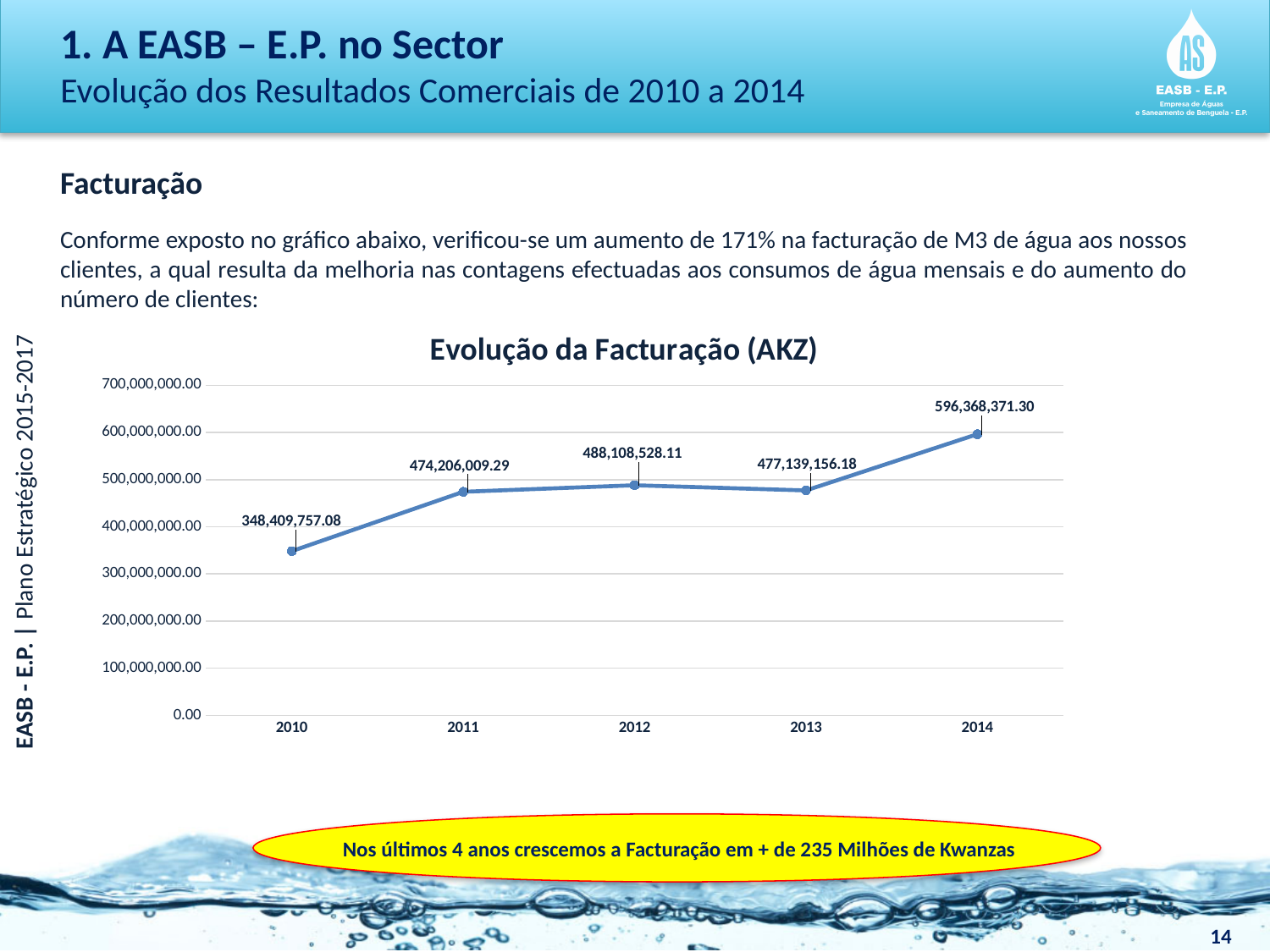
Is the value for 2010 greater or less than 400,000,000.00? less How many years are plotted in the Evolução da Facturação (AKZ) chart? 5 Which year has the larger value, 2012 or 2013? 2012 Which year has the highest value in the Evolução da Facturação (AKZ) chart? 2014 Which year has the lowest value in the Evolução da Facturação (AKZ) chart? 2010 What kind of chart is shown on the slide? line chart What is the value for 2010 in the Evolução da Facturação (AKZ) chart? 348,409,757.08 What is the value for 2012 in the Evolução da Facturação (AKZ) chart? 488,108,528.11 What is the value for 2014 in the Evolução da Facturação (AKZ) chart? 596,368,371.30 What is the difference between the 2012 and 2011 values in the Evolução da Facturação (AKZ) chart? 13,902,518.82 What is the title of the chart on the slide? Evolução da Facturação (AKZ) What is the difference between the 2014 and 2010 values in the Evolução da Facturação (AKZ) chart? 247,958,614.22